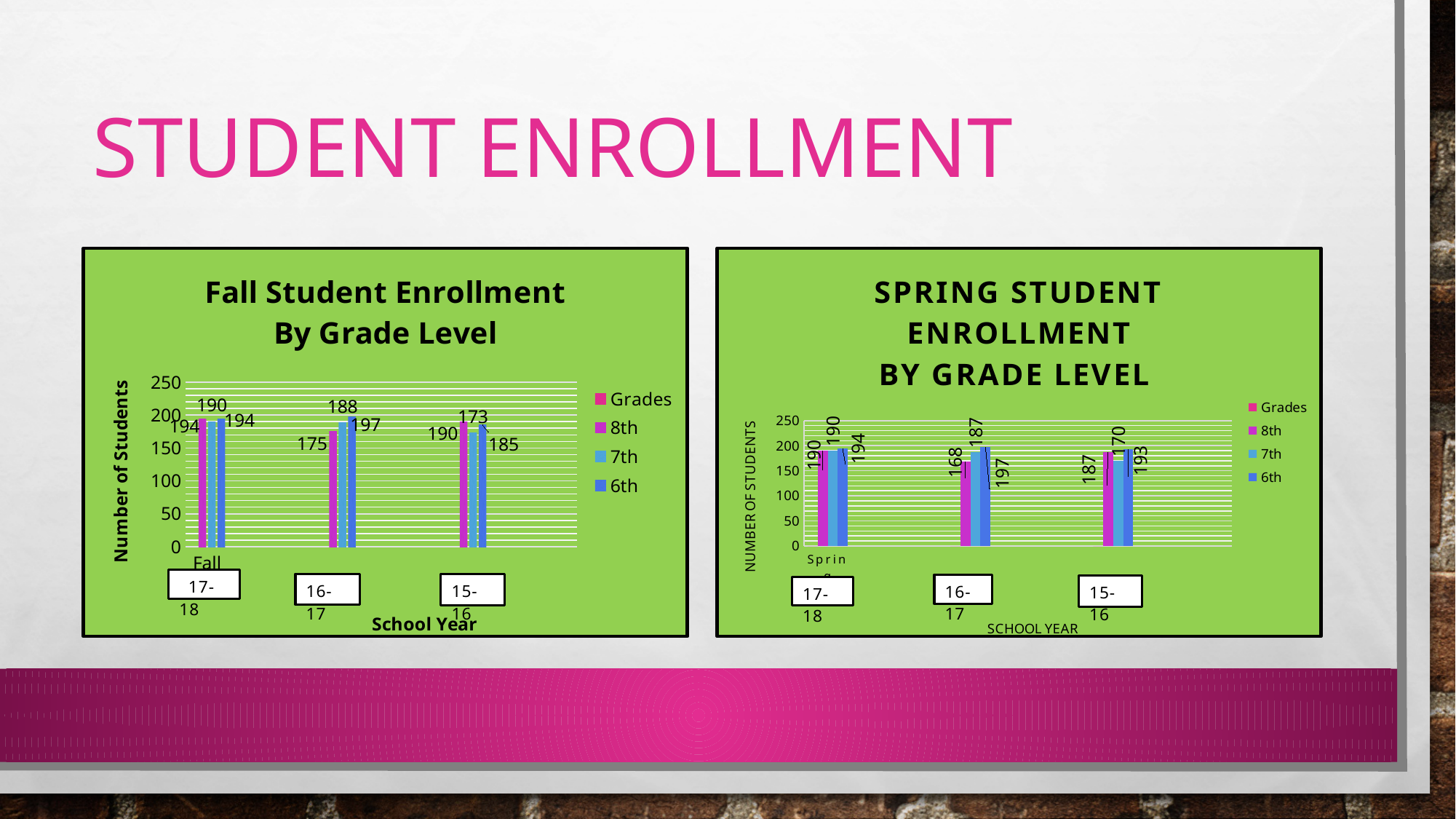
In the Spring Student Enrollment By Grade Level chart, what is the value for 8th grade in 16-17? 168 What is the title of the chart on the right side of the slide? SPRING STUDENT ENROLLMENT BY GRADE LEVEL In the Fall Student Enrollment By Grade Level chart, is the 7th grade value for 15-16 greater or less than 150? greater How many school years are shown on the x axis of the Spring Student Enrollment By Grade Level chart? 3 In the Fall Student Enrollment By Grade Level chart, which is larger for 16-17: the 6th grade value or the 8th grade value? 6th grade How many entries does the legend of the Fall Student Enrollment By Grade Level chart list? 4 In the Spring Student Enrollment By Grade Level chart, what is the difference between the 6th grade and 8th grade values for 16-17? 29 In the Fall Student Enrollment By Grade Level chart, what is the value for 6th grade in 16-17? 197 In the Fall Student Enrollment By Grade Level chart, what is the difference between the highest and lowest labelled values for 15-16? 17 What kind of chart is the Fall Student Enrollment By Grade Level chart? bar chart In the Spring Student Enrollment By Grade Level chart, what is the lowest labelled value? 168 In the Fall Student Enrollment By Grade Level chart, what is the highest labelled value? 197